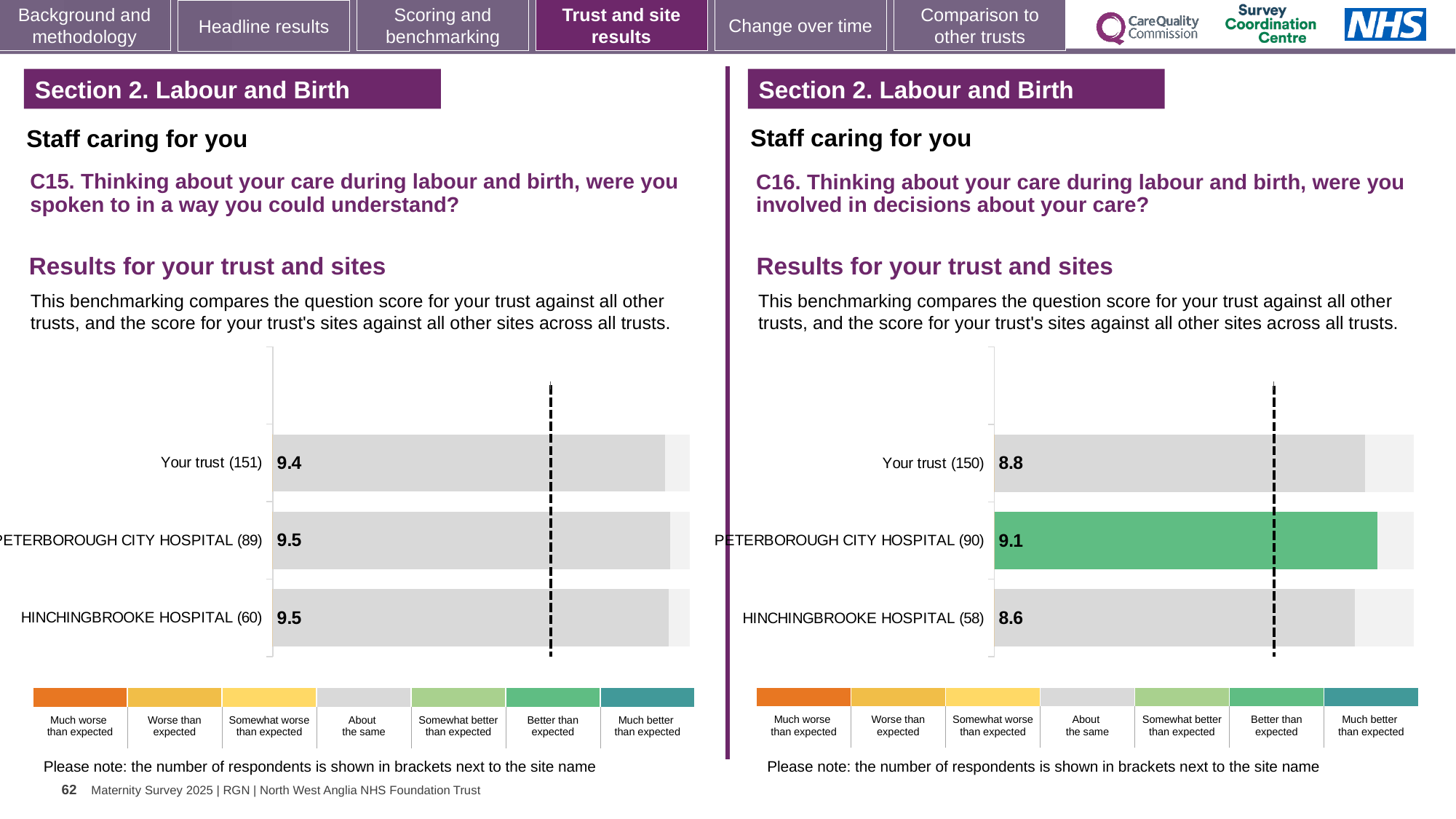
On the C16 chart (right), which site or trust has the lowest score? Hinchingbrooke Hospital On the C15 chart (left), which has the lowest score? Your trust On the C16 chart (right), what is the score for Peterborough City Hospital? 9.1 On the C15 chart (left), what is the score for Your trust? 9.4 On the C16 chart (right), how many respondents are shown in brackets for Your trust? 150 On the C16 chart (right), what is the difference between the scores for Peterborough City Hospital and Hinchingbrooke Hospital? 0.5 How many bars are shown on the C15 chart (left)? 3 On the C16 chart (right), what is the score for Hinchingbrooke Hospital? 8.6 On the C15 chart (left), what is the score for Peterborough City Hospital? 9.5 What type of chart is used for the C16 results (right)? Bar chart On the C16 chart (right), which has the larger score, Your trust or Peterborough City Hospital? Peterborough City Hospital On the C16 chart (right), which site or trust has the highest score? Peterborough City Hospital